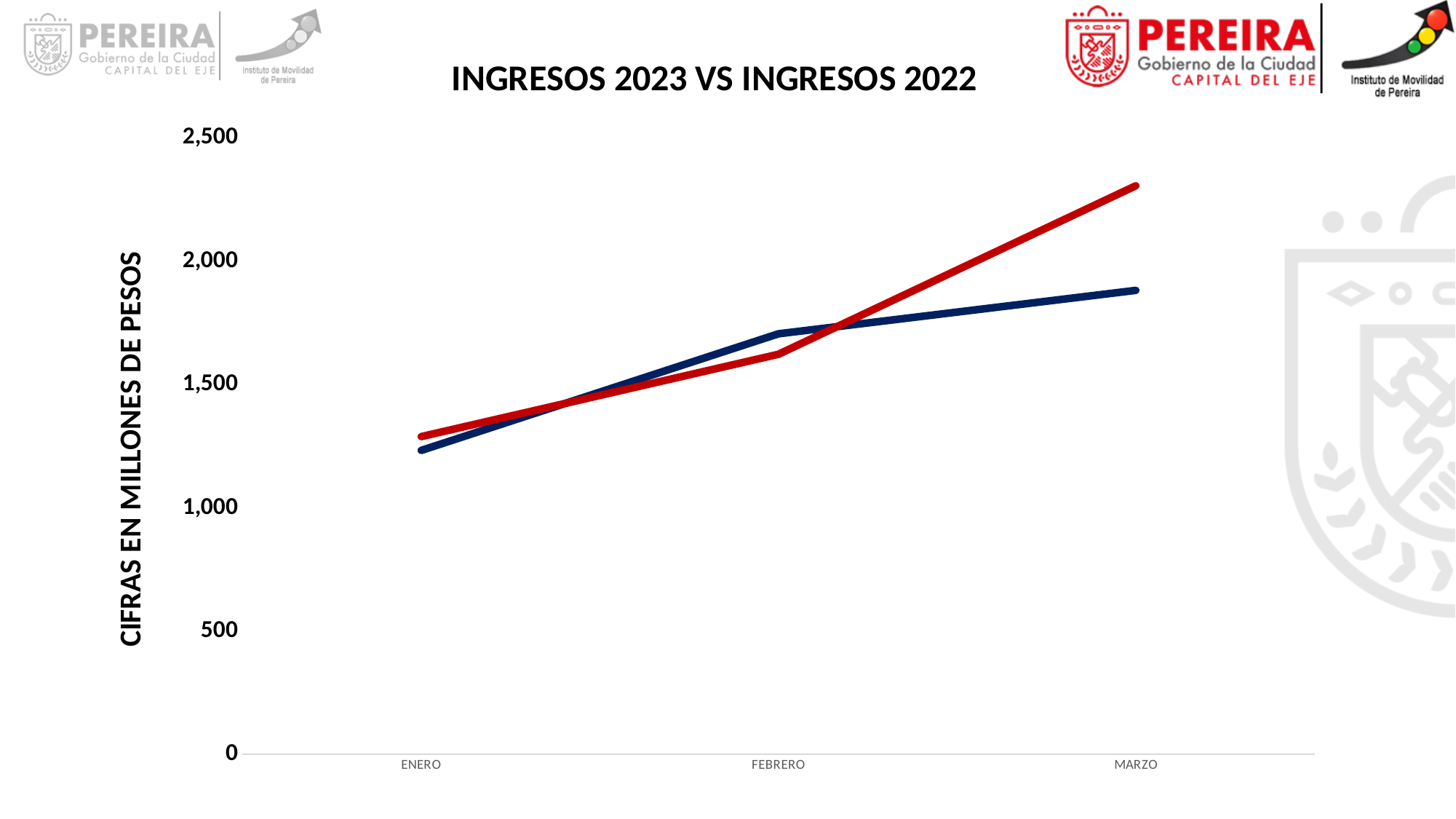
What is the title of the chart? INGRESOS 2023 VS INGRESOS 2022 Is the value of the red line at MARZO greater or less than 2,000? greater At FEBRERO, which line has the higher value, the red line or the blue line? the blue line How many categories are shown on the x axis? 3 Do the values of the red line rise or fall from ENERO to MARZO? rise Is the value of the red line at ENERO greater or less than 1,500? less What is the label on the vertical axis? CIFRAS EN MILLONES DE PESOS At MARZO, which line has the higher value, the red line or the blue line? the red line Is the value of the blue line at FEBRERO greater or less than 1,500? greater What kind of chart is shown on the slide? line chart How many lines are plotted on the chart? 2